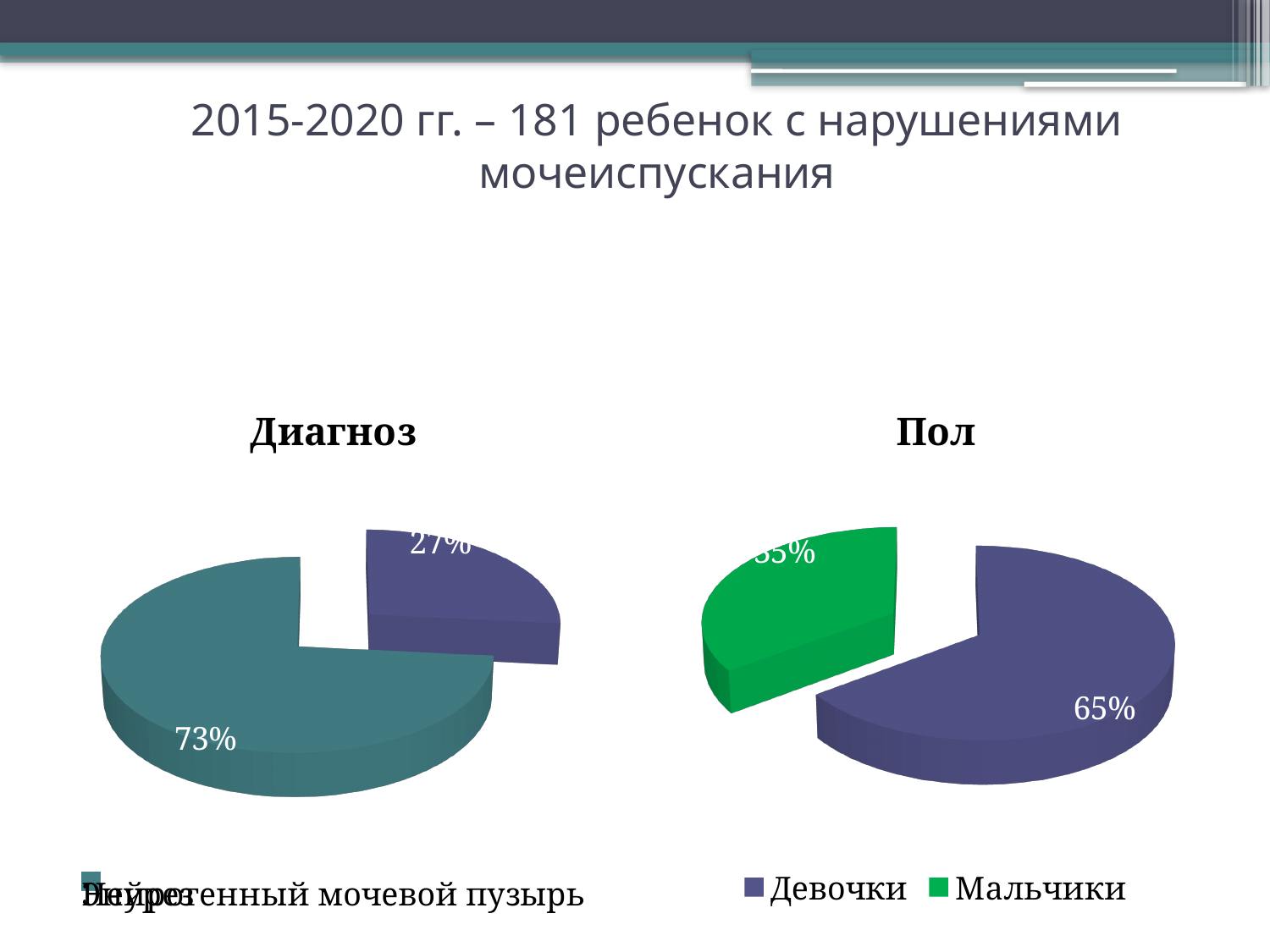
How many slices does the "Пол" pie chart have? 2 In the "Пол" chart, what colour is the Мальчики slice? Green In the "Пол" chart, which category has the smallest share? Мальчики In the "Пол" chart, what percentage is shown for Девочки? 65% In the "Пол" chart, what is the difference in percentage points between Девочки and Мальчики? 30 How many entries does the legend of the "Пол" chart list? 2 In the "Пол" chart, which category has the largest share? Девочки In the "Пол" chart, what percentage is shown for Мальчики? 35% In the "Диагноз" chart, what percentage is shown on the smallest slice? 27% What kind of chart is the "Пол" chart? Pie chart In the "Диагноз" chart, what percentage is shown on the largest slice? 73% In the "Пол" chart, which is larger: Девочки or Мальчики? Девочки